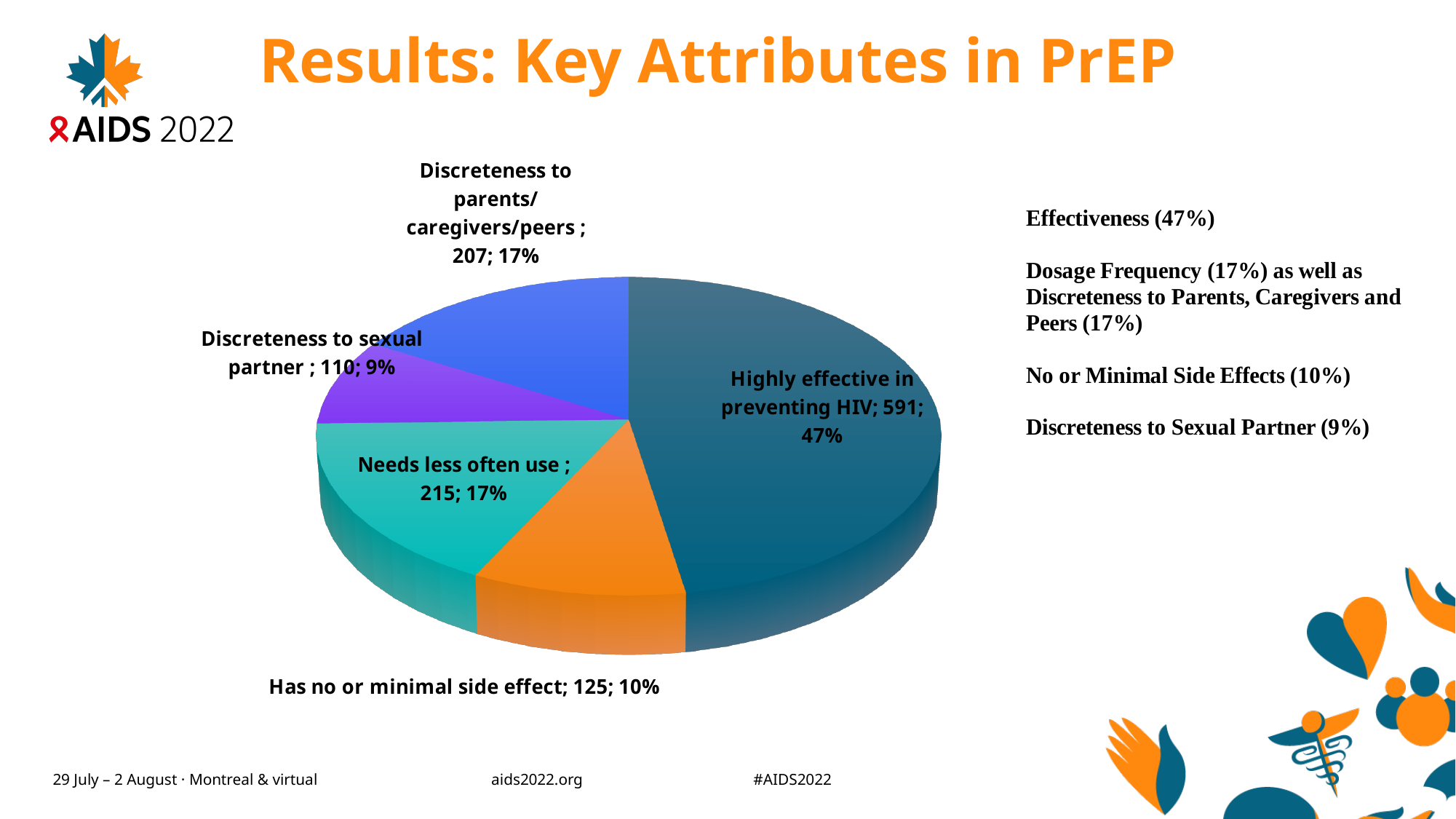
What is the difference between the values for 'Has no or minimal side effect' and 'Discreteness to sexual partner'? 15 Which is larger: the value for 'Discreteness to parents/caregivers/peers' or the value for 'Has no or minimal side effect'? Discreteness to parents/caregivers/peers Which category has the largest slice of the pie chart? Highly effective in preventing HIV What is the value for 'Discreteness to sexual partner'? 110 What is the title of the slide containing the pie chart? Results: Key Attributes in PrEP What kind of chart is shown on the slide? Pie chart Which category has the smallest slice of the pie chart? Discreteness to sexual partner What percentage share does 'Needs less often use' have in the pie chart? 17% What percentage share does 'Has no or minimal side effect' have? 10% How many slices does the pie chart have? 5 What is the value for 'Highly effective in preventing HIV'? 591 What is the difference between the values for 'Highly effective in preventing HIV' and 'Needs less often use'? 376